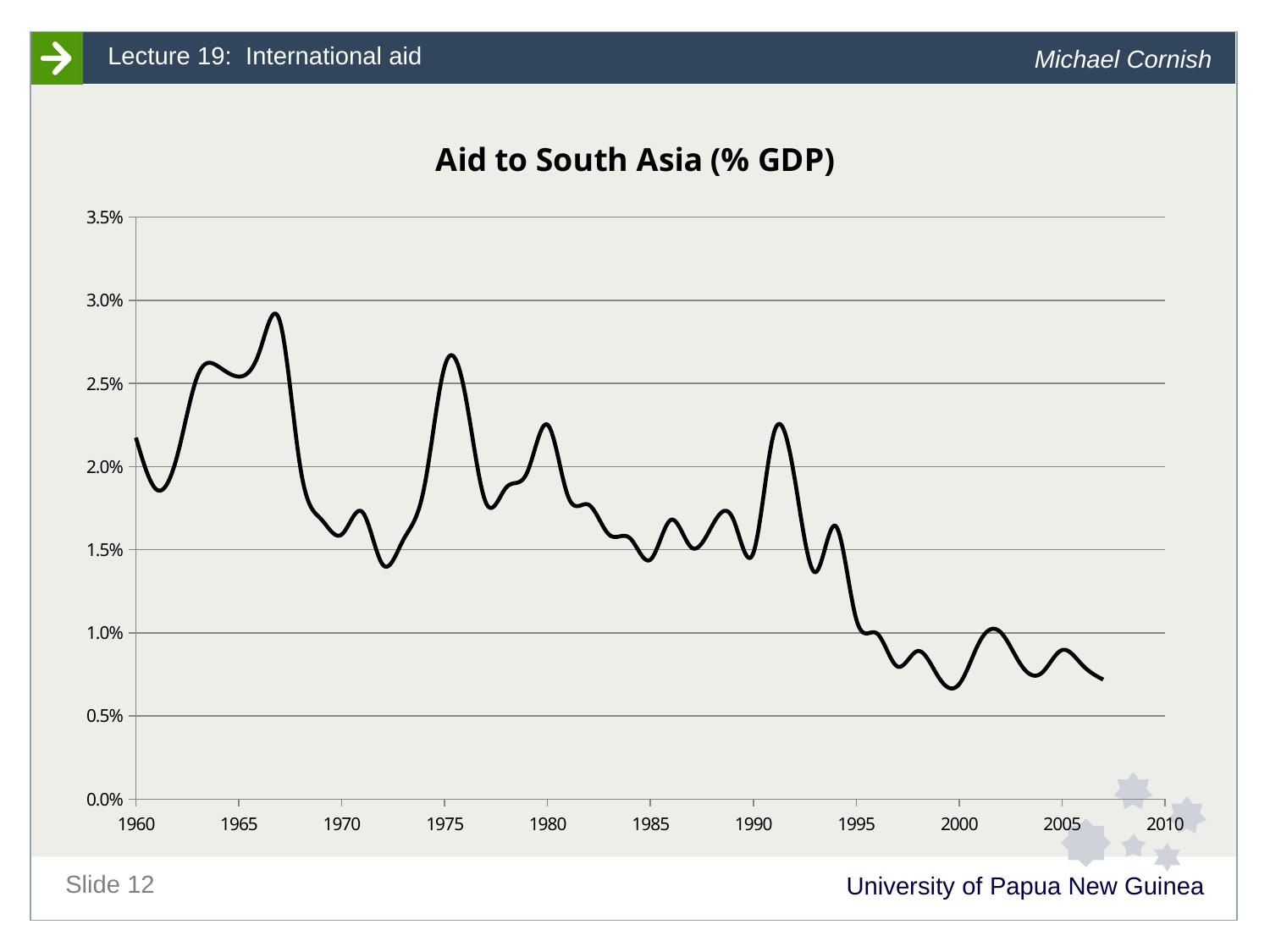
Around which year does the line reach its highest value? 1967 Which is larger, the value for 1960 or the value for 2005? 1960 What kind of chart is shown on the slide? line chart Is the value for 1975 greater or less than 2.5%? greater Is the value for 2000 greater or less than 1.0%? less Which is larger, the value for 1980 or the value for 1990? 1980 Is the value for 1980 greater or less than 2.0%? greater Overall, do the values rise or fall from 1960 to 2010 along the x axis? fall What is the highest value shown on the y axis? 3.5% What is the title of the chart? Aid to South Asia (% GDP)